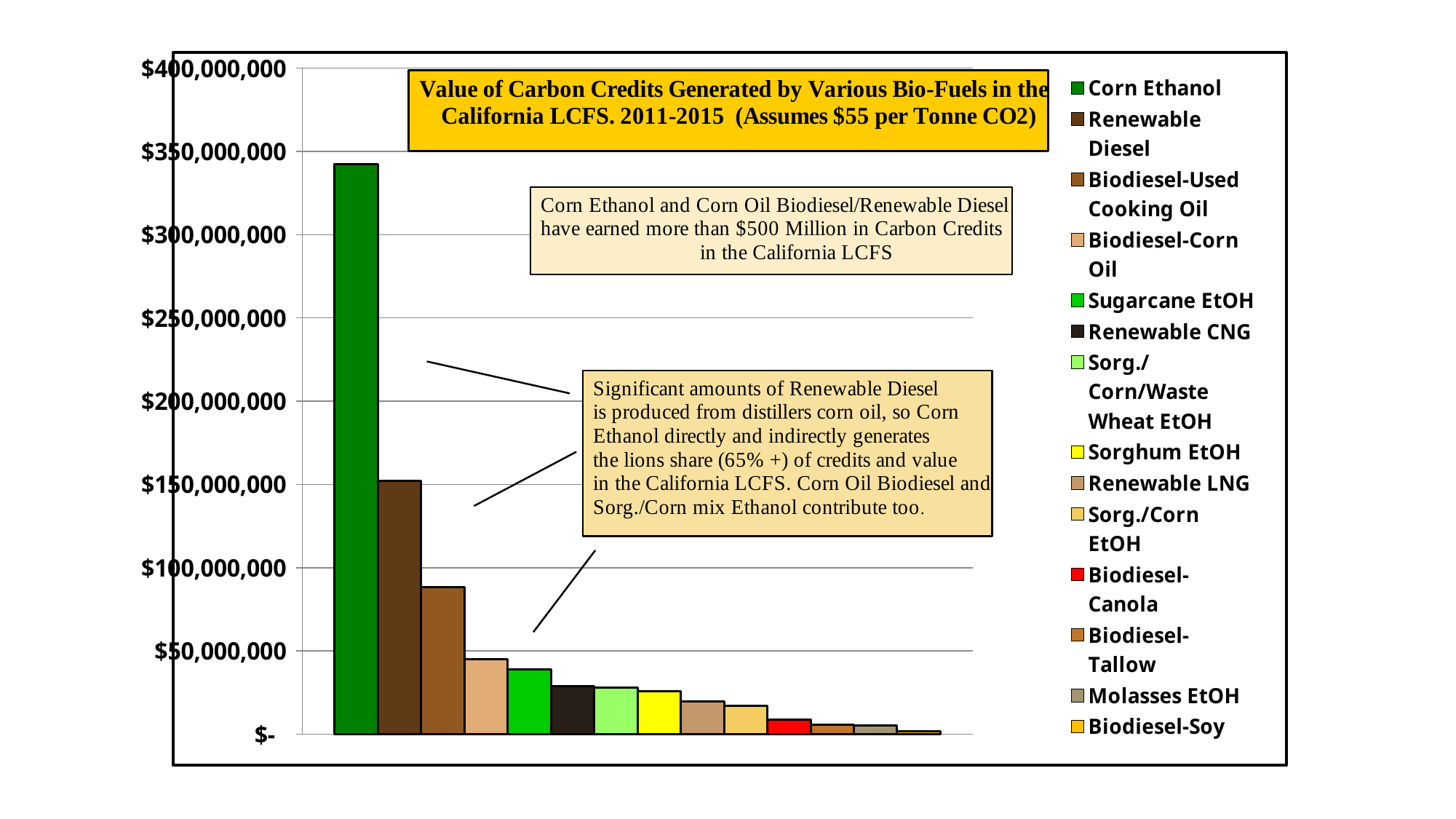
Is the value for Corn Ethanol greater or less than $300,000,000? greater What carbon price per tonne of CO2 does the chart title say is assumed? $55 per Tonne CO2 Which is larger, the value for Renewable Diesel or the value for Biodiesel-Used Cooking Oil? Renewable Diesel Do the bar values rise or fall from left to right across the chart? Fall How many entries does the legend list? 14 Which bio-fuel has the highest value of carbon credits? Corn Ethanol Which bio-fuel has the lowest value of carbon credits? Biodiesel-Soy Is the value for Biodiesel-Used Cooking Oil greater or less than $50,000,000? greater Is the value for Sugarcane EtOH greater or less than $50,000,000? less How many bars are plotted in the chart? 14 What kind of chart is shown on the slide? Bar chart